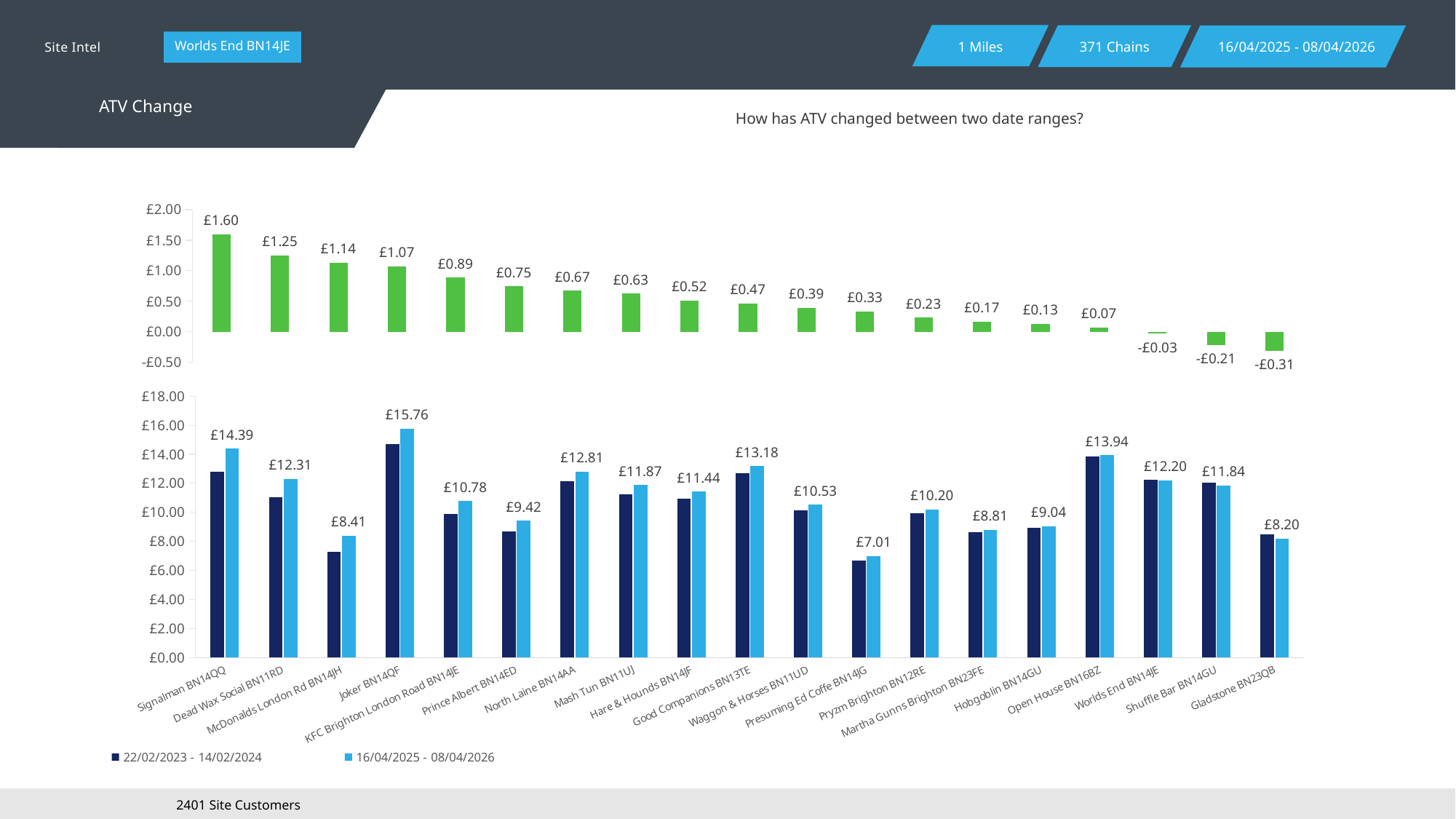
In the bottom chart, which is larger in the 16/04/2025 - 08/04/2026 series: Mash Tun BN11UJ or Hare & Hounds BN14JF? Mash Tun BN11UJ How many series does the legend of the bottom chart list? 2 In the bottom chart, is the value for Signalman BN14QQ in the 22/02/2023 - 14/02/2024 series greater or less than £14.00? less In the top chart (ATV change), which category has the highest value? Signalman BN14QQ In the top chart (ATV change), what is the difference between the values for Joker BN14QF and Prince Albert BN14ED? £0.32 In the top chart (ATV change), what is the value for Gladstone BN23QB? -£0.31 How many categories are shown on the x axis of the bottom chart? 19 In the top chart (ATV change), what is the value for Signalman BN14QQ? £1.60 In the bottom chart, what is the value for Joker BN14QF in the 16/04/2025 - 08/04/2026 series? £15.76 In the bottom chart, which category has the lowest value in the 16/04/2025 - 08/04/2026 series? Presuming Ed Coffe BN14JG In the top chart (ATV change), which category has the lowest value? Gladstone BN23QB In the bottom chart, which category has the highest value in the 16/04/2025 - 08/04/2026 series? Joker BN14QF